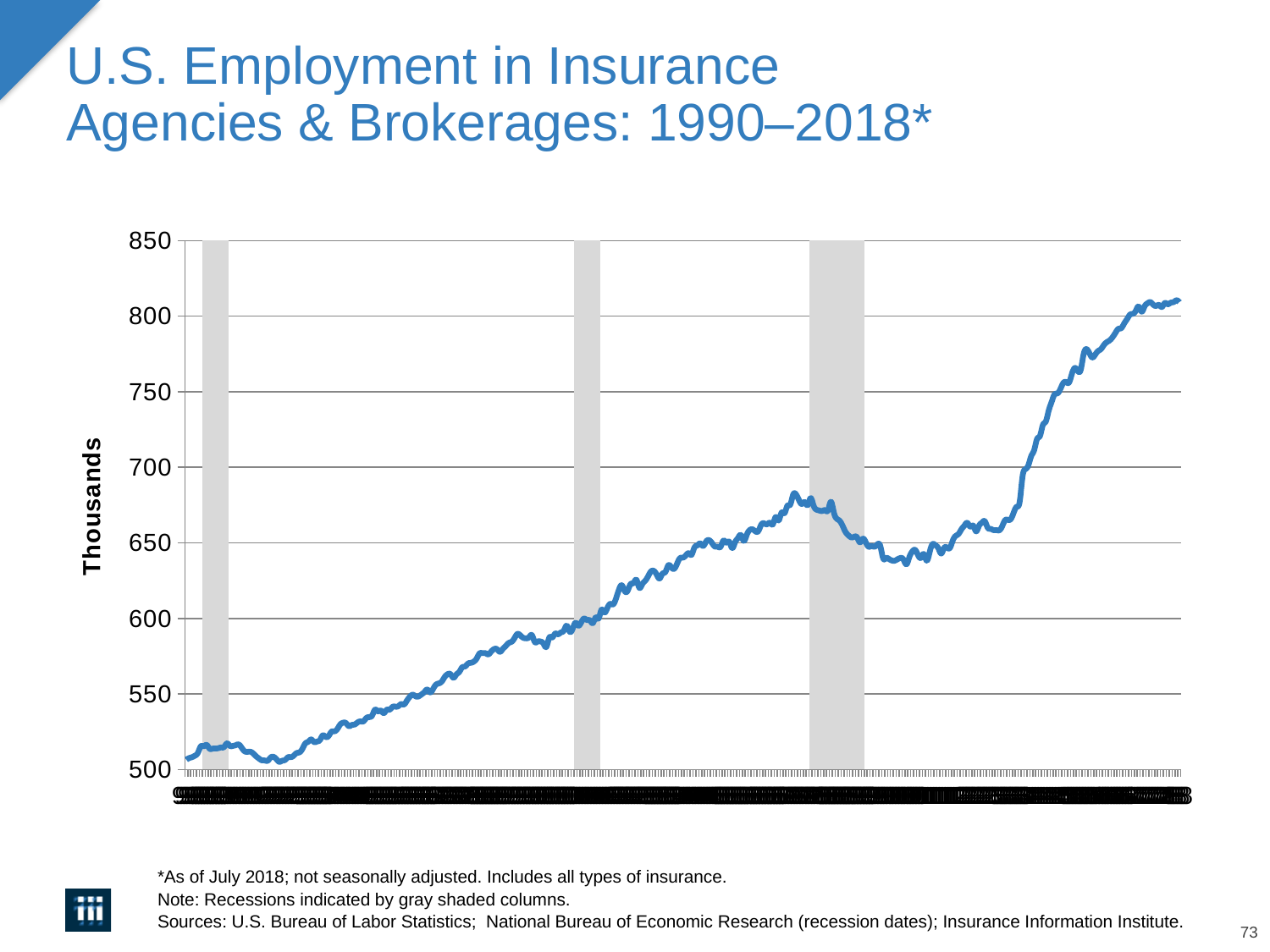
Is the highest point reached by the line greater or less than 800? greater Is the peak of the line just before the third gray shaded column greater or less than 700? less Is the value at the right end of the line (the most recent point) greater or less than 800? greater How many gray shaded recession columns are shown on the chart? 3 What is the label on the vertical axis? Thousands What kind of chart is shown on the slide? line chart Overall, do the values rise or fall from the left of the x axis to the right? rise